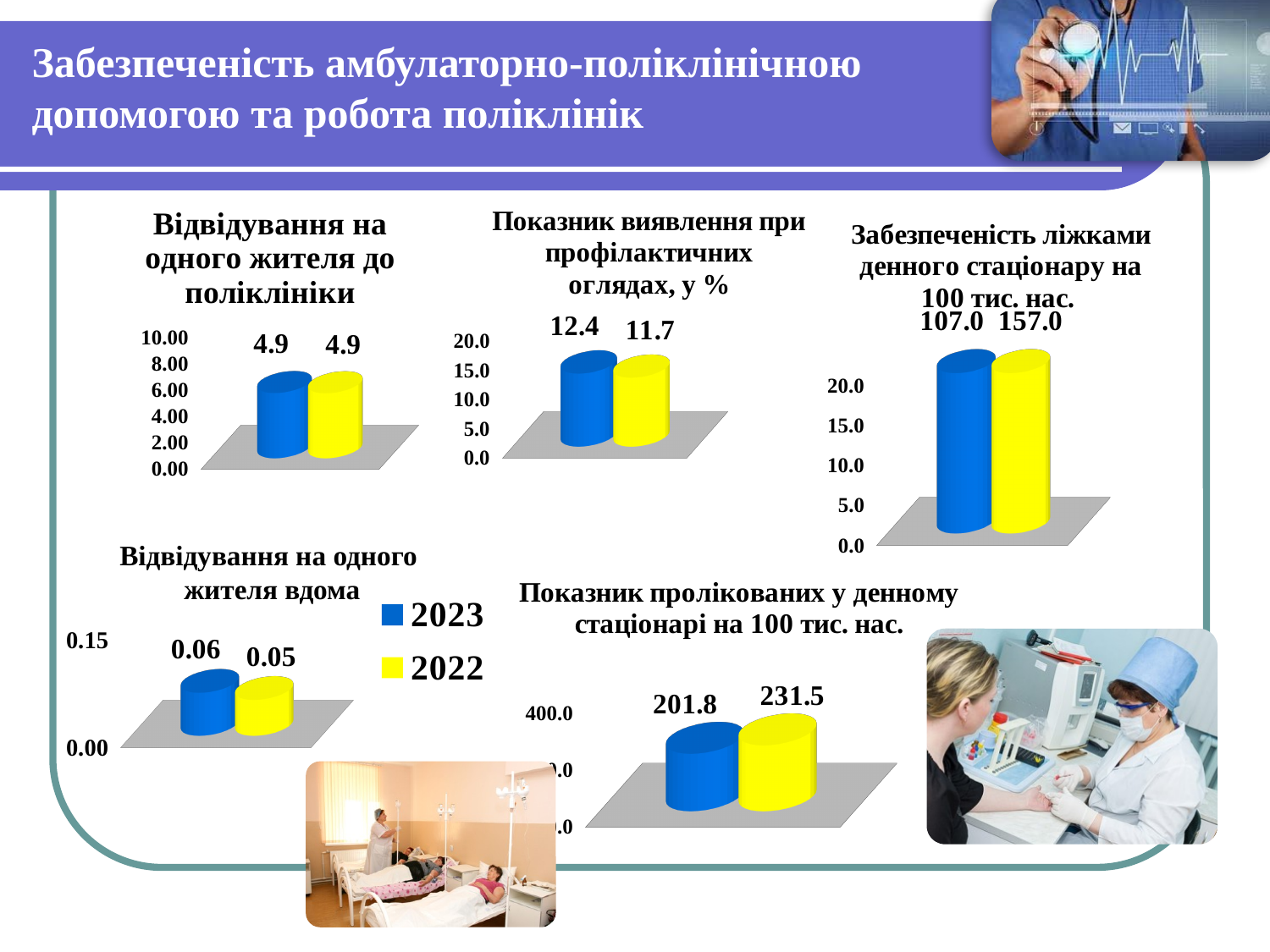
In the chart 'Показник виявлення при профілактичних оглядах, у %', which year has the lower value? 2022 In the chart 'Показник пролікованих у денному стаціонарі на 100 тис. нас.', which year has the higher value? 2022 In the chart 'Показник пролікованих у денному стаціонарі на 100 тис. нас.', what is the value for 2023? 201.8 In the chart 'Відвідування на одного жителя до поліклініки', what is the value for 2022? 4.9 In the chart 'Забезпеченість ліжками денного стаціонару на 100 тис. нас.', what is the difference between the 2022 and 2023 values? 50.0 In the chart 'Відвідування на одного жителя вдома', what is the value for 2023? 0.06 In the chart 'Забезпеченість ліжками денного стаціонару на 100 тис. нас.', what is the value for 2022? 157.0 In the chart 'Показник виявлення при профілактичних оглядах, у %', what is the value for 2023? 12.4 In the chart 'Показник виявлення при профілактичних оглядах, у %', what is the value for 2022? 11.7 How many series does the legend on the slide list? 2 What type of chart is 'Відвідування на одного жителя вдома'? Bar chart In the chart 'Показник пролікованих у денному стаціонарі на 100 тис. нас.', what is the difference between the 2022 and 2023 values? 29.7